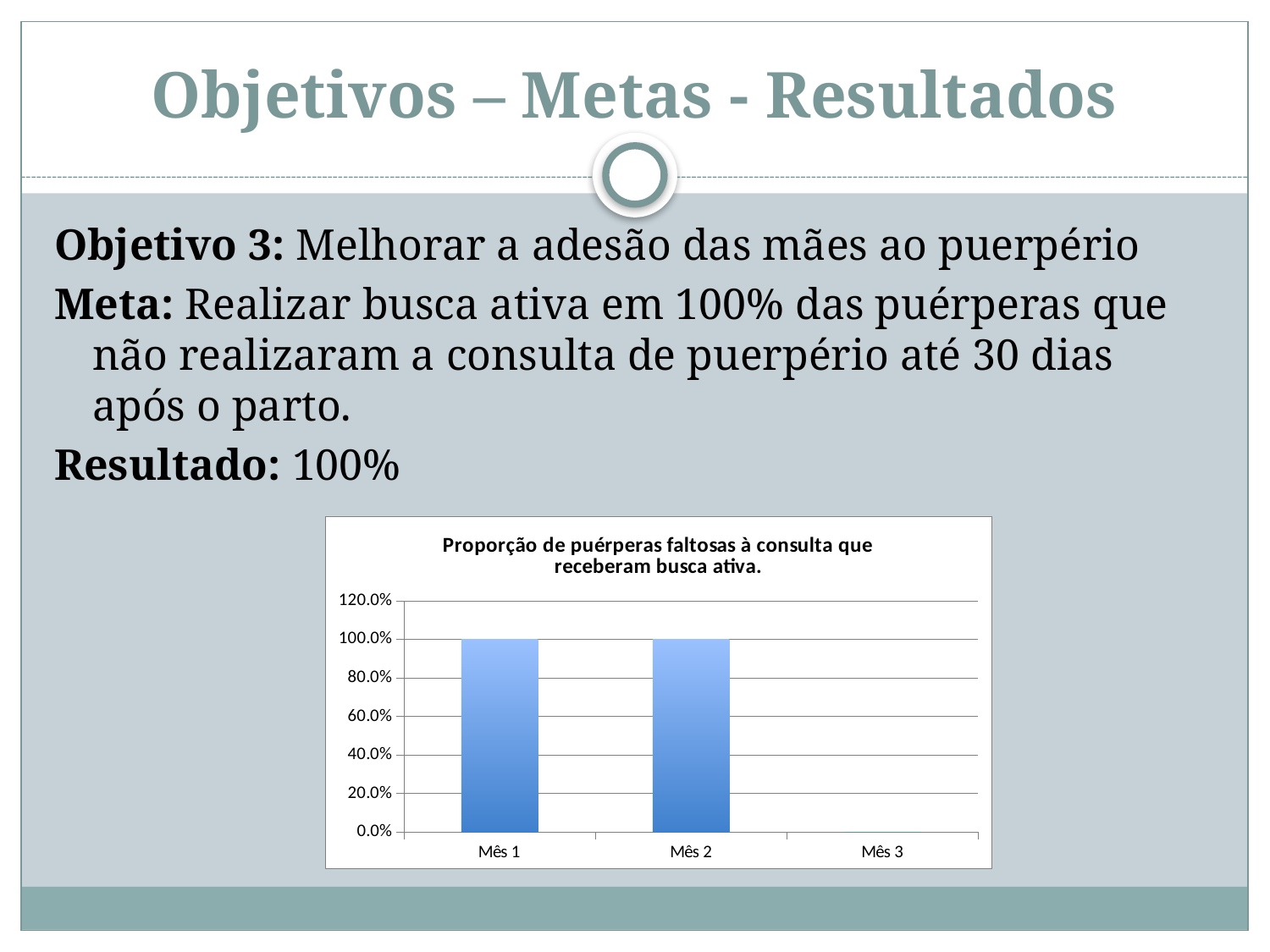
What is the value for Mês 2 in the chart? 100.0% Which is larger, the value for Mês 1 or the value for Mês 3? Mês 1 How many categories are shown on the x axis of the chart? 3 Does the value rise or fall from Mês 2 to Mês 3? fall Is the value for Mês 2 greater or less than 80.0%? greater What is the title of the chart? Proporção de puérperas faltosas à consulta que receberam busca ativa. What is the value for Mês 1 in the chart? 100.0% Which category has the lowest value in the chart? Mês 3 Is the value for Mês 3 greater or less than 20.0%? less What is the highest value shown on the y axis of the chart? 120.0% What type of chart is shown on the slide? bar chart What is the difference between the values for Mês 1 and Mês 2? 0.0%